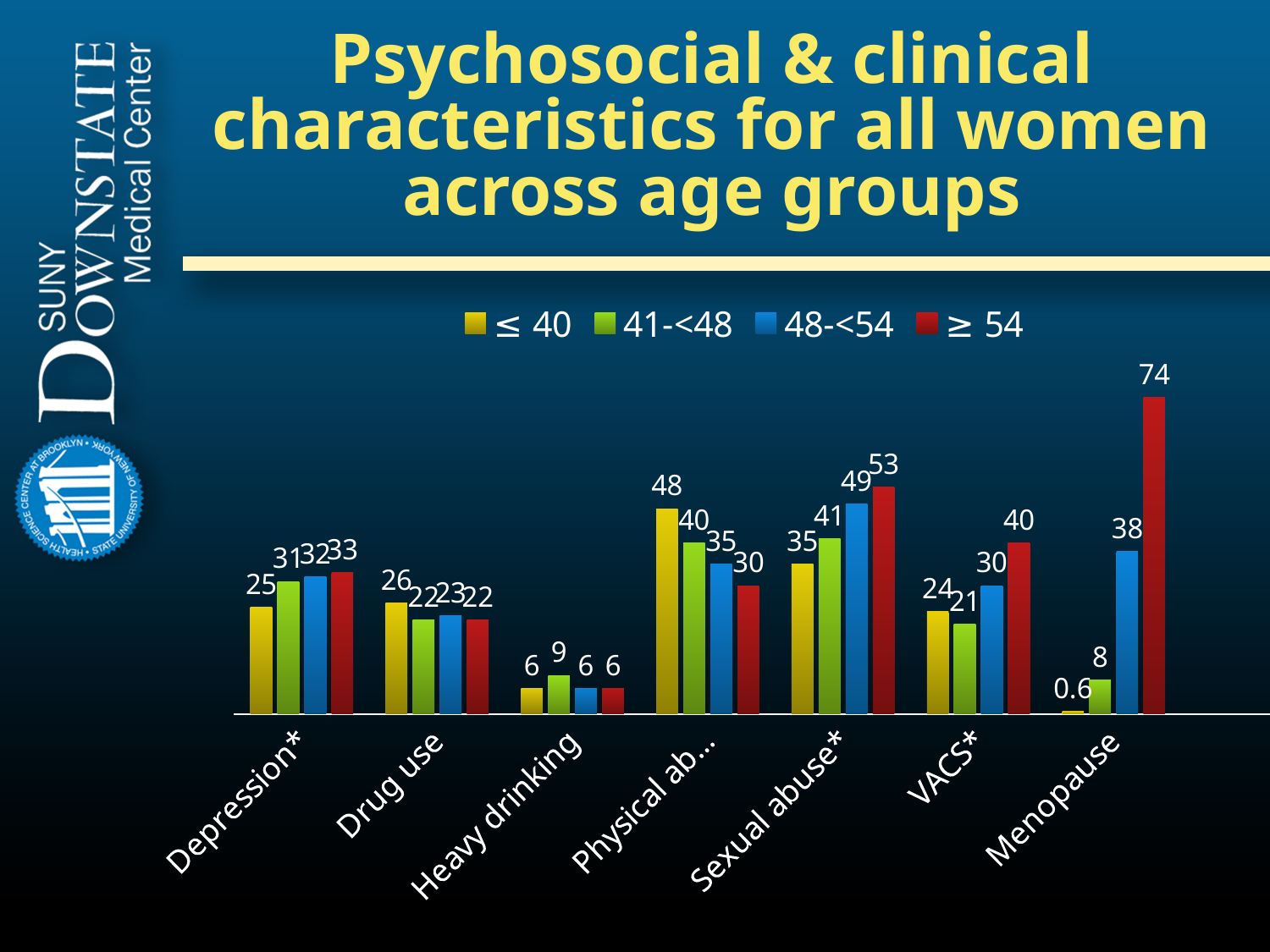
How many age groups does the legend list? 4 Which is larger: the ≥ 54 value for VACS* or the ≥ 54 value for Depression*? VACS* In the Sexual abuse* category, do the values rise or fall from the youngest to the oldest age group? Rise What is the value for the ≥ 54 age group in the Menopause category? 74 What is the difference between the ≥ 54 and ≤ 40 values in the Depression* category? 8 Which category and age group has the highest value on the chart? Menopause, ≥ 54 Which category and age group has the lowest value on the chart? Menopause, ≤ 40 What is the difference between the ≥ 54 and 48-<54 values in the Menopause category? 36 What is the value for the 48-<54 age group in the Sexual abuse* category? 49 How many categories are shown on the x axis? 7 What kind of chart is shown on the slide? Bar chart What is the value for the 41-<48 age group in the Heavy drinking category? 9